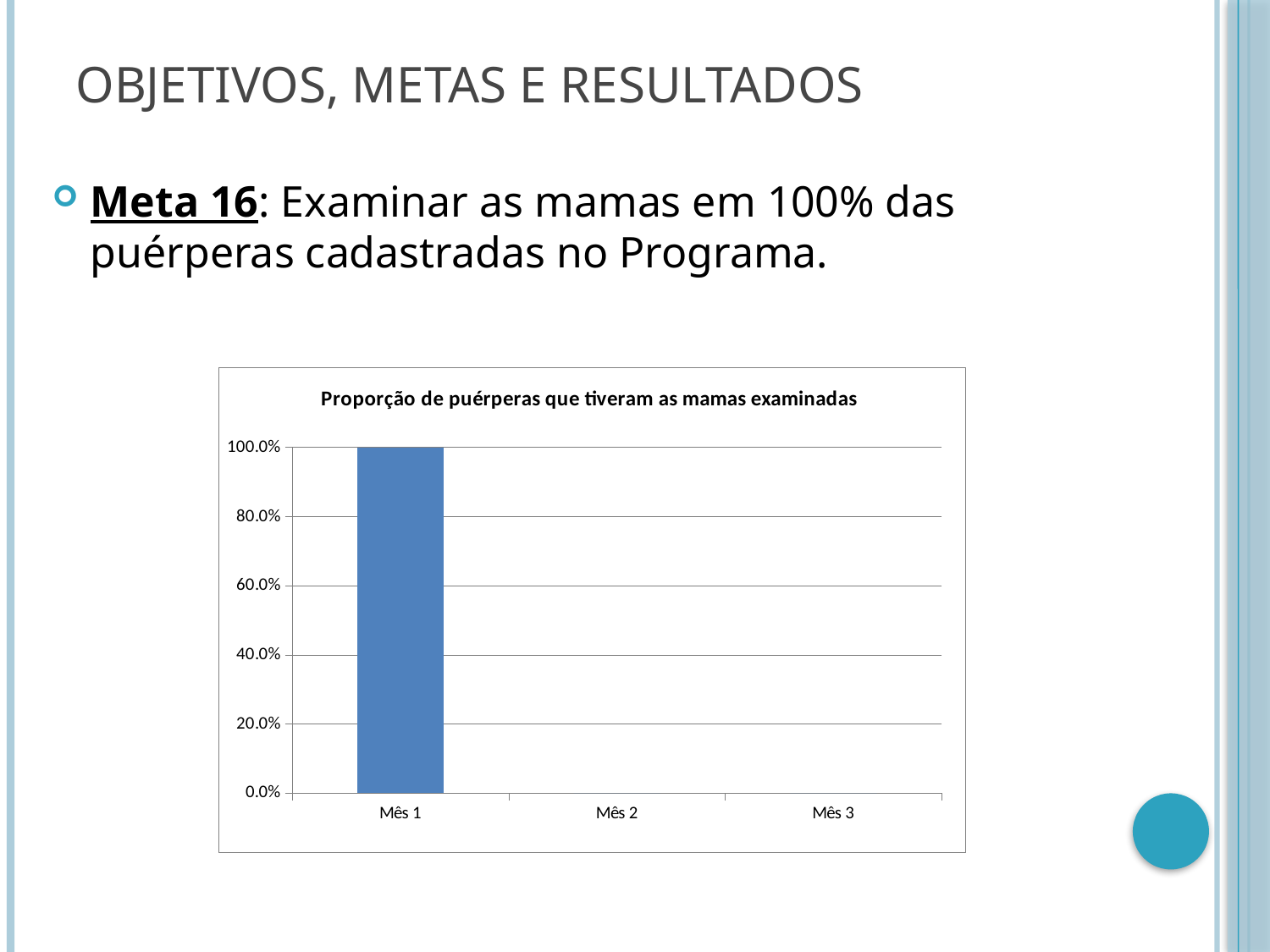
Is the value for Mês 1 greater or less than 80.0%? greater What type of chart is shown on the slide? bar chart What is the highest tick value shown on the y axis of the chart? 100.0% What is the value for Mês 1 in the chart? 100.0% Which is larger, the value for Mês 1 or the value for Mês 2? Mês 1 What is the title of the chart? Proporção de puérperas que tiveram as mamas examinadas How many categories are shown on the x axis of the chart? 3 How many categories in the chart have a visible bar? 1 Which category has the highest value in the chart? Mês 1